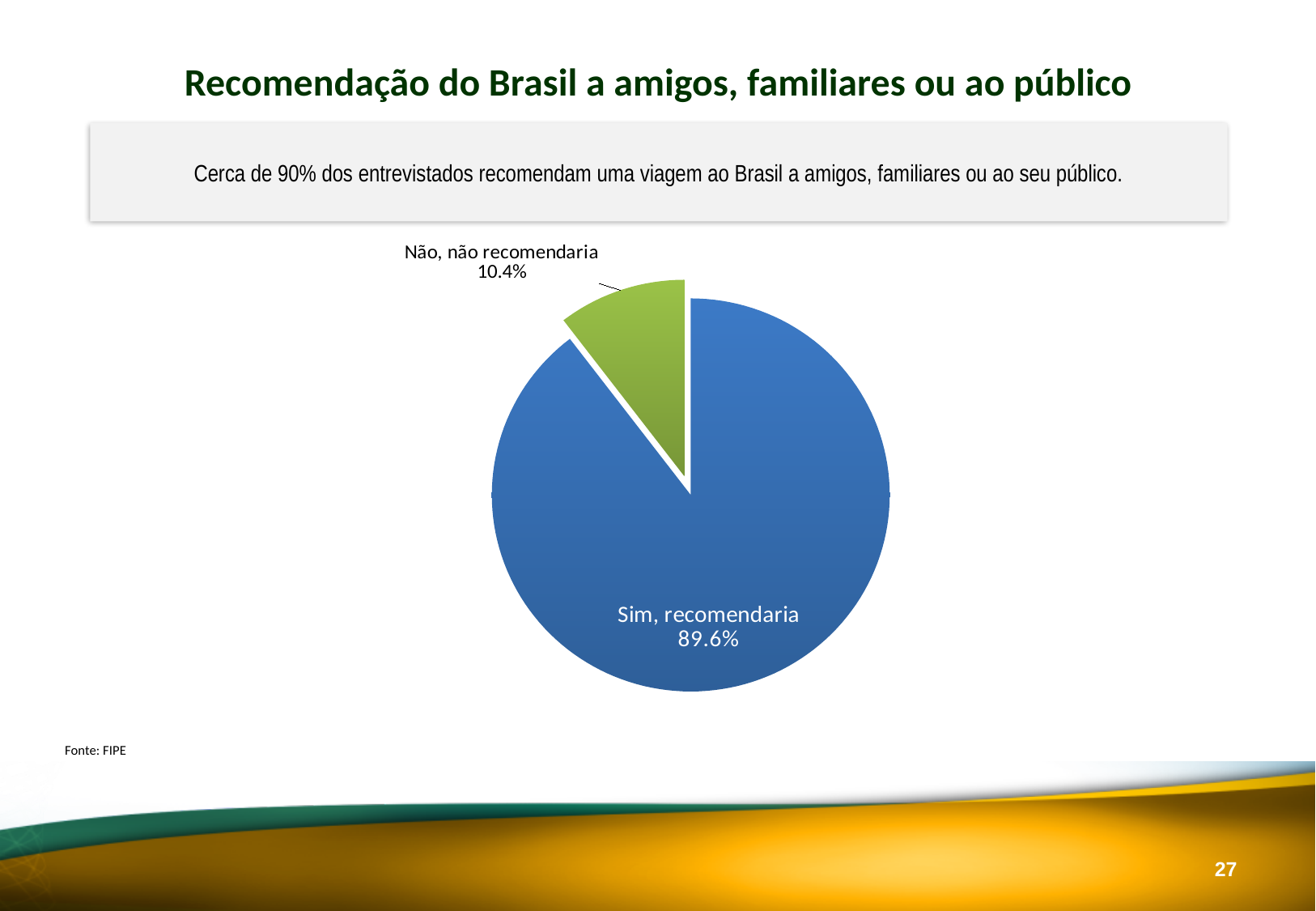
How many slices does the pie chart have? 2 Which slice of the pie is the largest? Sim, recomendaria What is the total of the two slices shown in the pie chart? 100% What kind of chart is shown on the slide? Pie chart What share of respondents answered "Não, não recomendaria"? 10.4% What colour is the "Sim, recomendaria" slice? Blue Which is larger: the share for "Sim, recomendaria" or for "Não, não recomendaria"? Sim, recomendaria What is the source cited for the chart? FIPE What share of respondents answered "Sim, recomendaria"? 89.6% Which slice of the pie is the smallest? Não, não recomendaria What is the difference in percentage points between "Sim, recomendaria" and "Não, não recomendaria"? 79.2